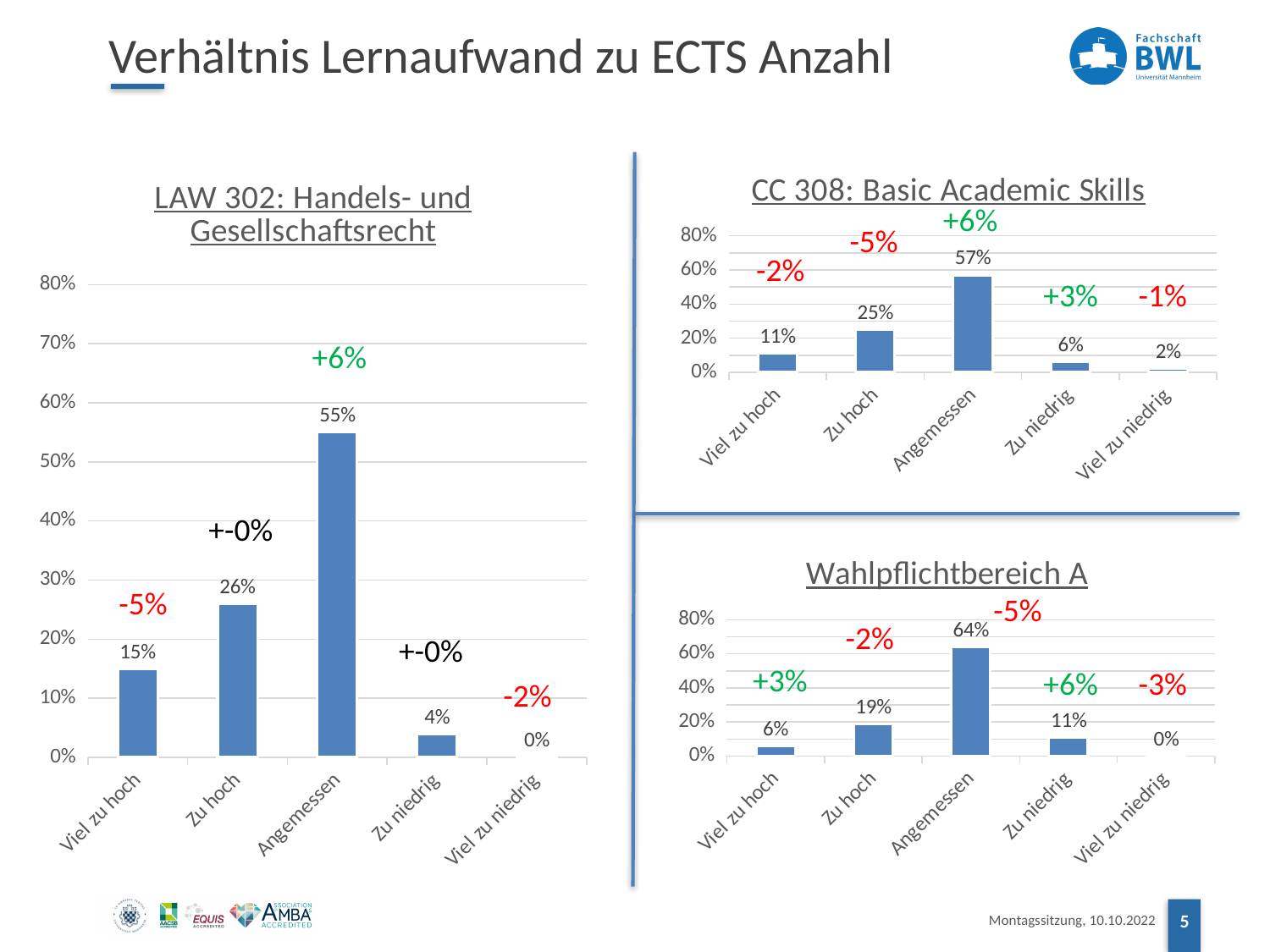
In the LAW 302: Handels- und Gesellschaftsrecht chart, which category has the lowest value? Viel zu niedrig In the Wahlpflichtbereich A chart, which category has the highest value? Angemessen In the LAW 302: Handels- und Gesellschaftsrecht chart, what is the value for Angemessen? 55% In the Wahlpflichtbereich A chart, what is the value for Zu niedrig? 11% In the CC 308: Basic Academic Skills chart, what is the value for Angemessen? 57% In the LAW 302: Handels- und Gesellschaftsrecht chart, what is the value for Zu hoch? 26% In the LAW 302: Handels- und Gesellschaftsrecht chart, what is the difference between Zu hoch and Viel zu hoch? 11% In the CC 308: Basic Academic Skills chart, what is the value for Viel zu niedrig? 2% What type of chart is the CC 308: Basic Academic Skills chart? Bar chart How many categories are shown on the x axis of the Wahlpflichtbereich A chart? 5 In the Wahlpflichtbereich A chart, what is the difference between Angemessen and Zu hoch? 45% In the CC 308: Basic Academic Skills chart, which is larger, Viel zu hoch or Zu niedrig? Viel zu hoch